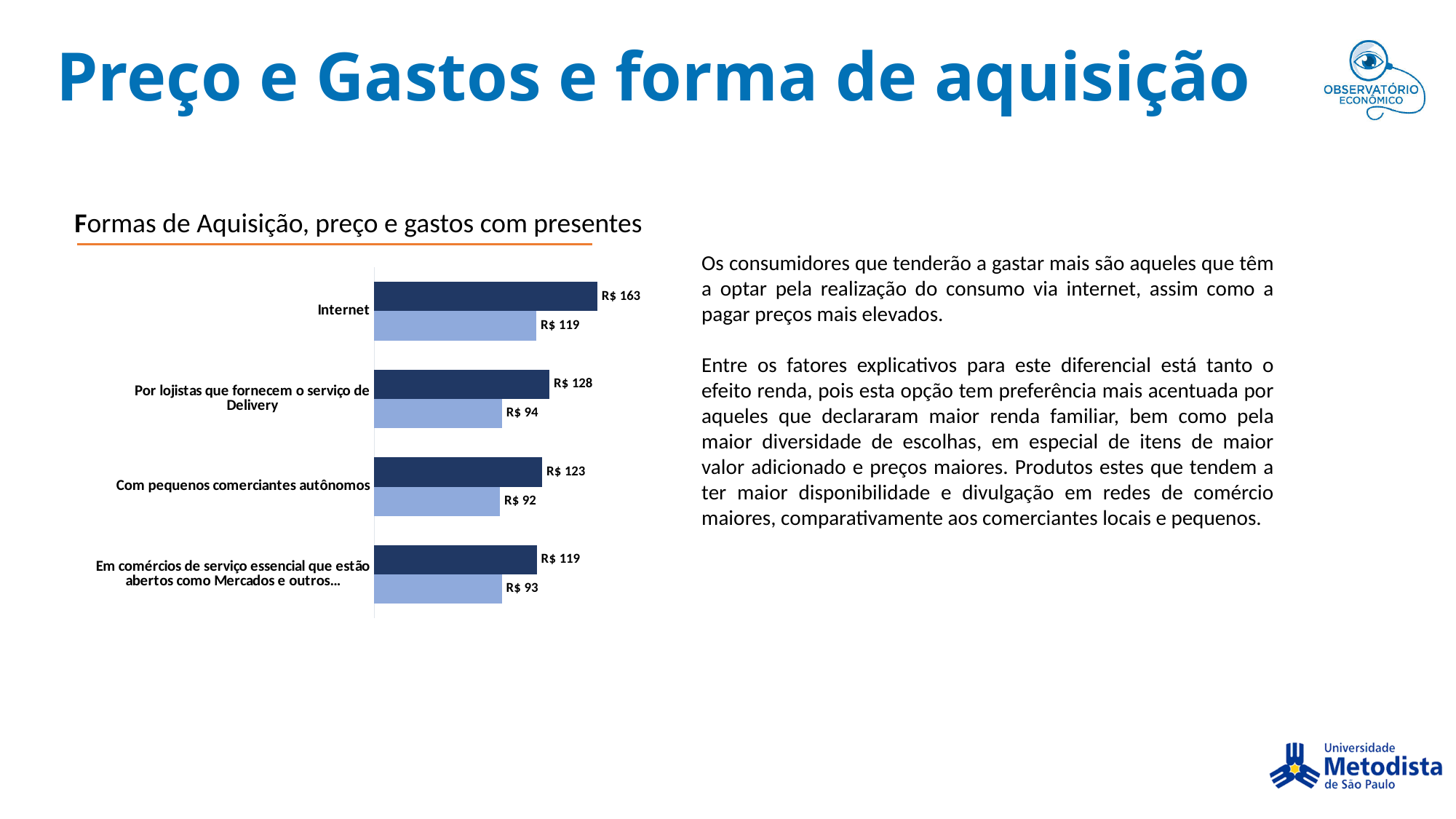
What kind of chart is shown on the slide? bar chart Which category has the highest dark blue bar value? Internet What is the light blue bar value for 'Com pequenos comerciantes autônomos'? R$ 92 What is the title of the chart? Formas de Aquisição, preço e gastos com presentes What is the difference between the dark blue and light blue bar values for Internet? R$ 44 What is the dark blue bar value for Internet? R$ 163 What is the difference between the dark blue values for Internet and 'Por lojistas que fornecem o serviço de Delivery'? R$ 35 What is the dark blue bar value for 'Por lojistas que fornecem o serviço de Delivery'? R$ 128 Which is larger: the light blue value for 'Por lojistas que fornecem o serviço de Delivery' or the light blue value for 'Em comércios de serviço essencial que estão abertos como Mercados e outros...'? Por lojistas que fornecem o serviço de Delivery What is the light blue bar value for Internet? R$ 119 How many categories are shown in the chart? 4 Which category has the lowest light blue bar value? Com pequenos comerciantes autônomos